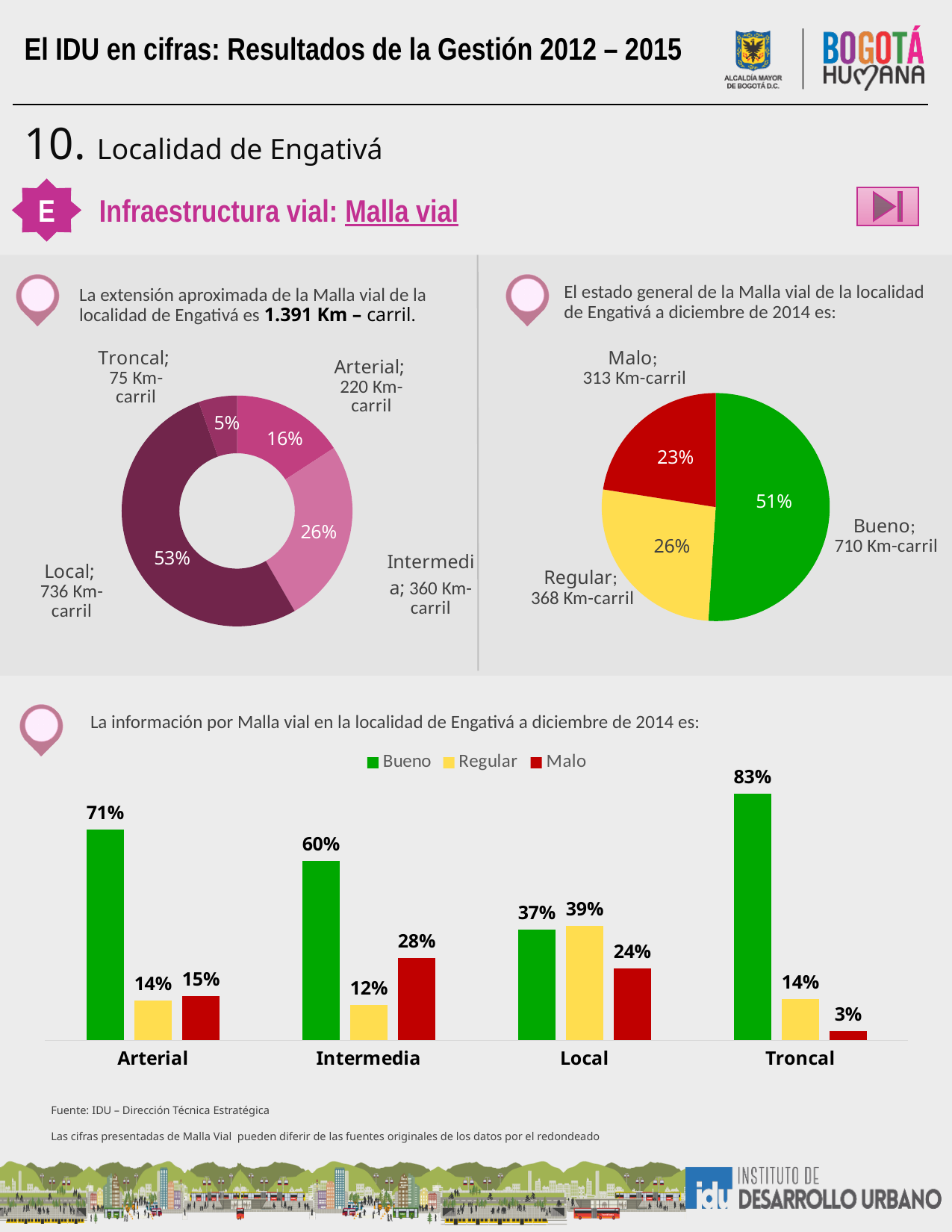
In the pie chart on the right, what percentage is labelled Bueno? 51% In the donut chart on the left, what percentage share does Local have? 53% In the bottom bar chart, what is the difference between the Bueno and Malo values for Intermedia? 32% In the bottom bar chart, how many series does the legend list? 3 In the bottom bar chart, what is the Regular value for Local? 39% In the pie chart on the right, how many Km-carril are labelled Malo? 313 Km-carril In the bottom bar chart, which is larger for Local: Bueno or Regular? Regular In the pie chart on the right, which category has the largest share? Bueno In the donut chart on the left, how many categories are shown? 4 In the bottom bar chart, what is the Bueno value for Troncal? 83% In the donut chart on the left, which category has the smallest share? Troncal In the donut chart on the left, how many Km-carril does Arterial have? 220 Km-carril